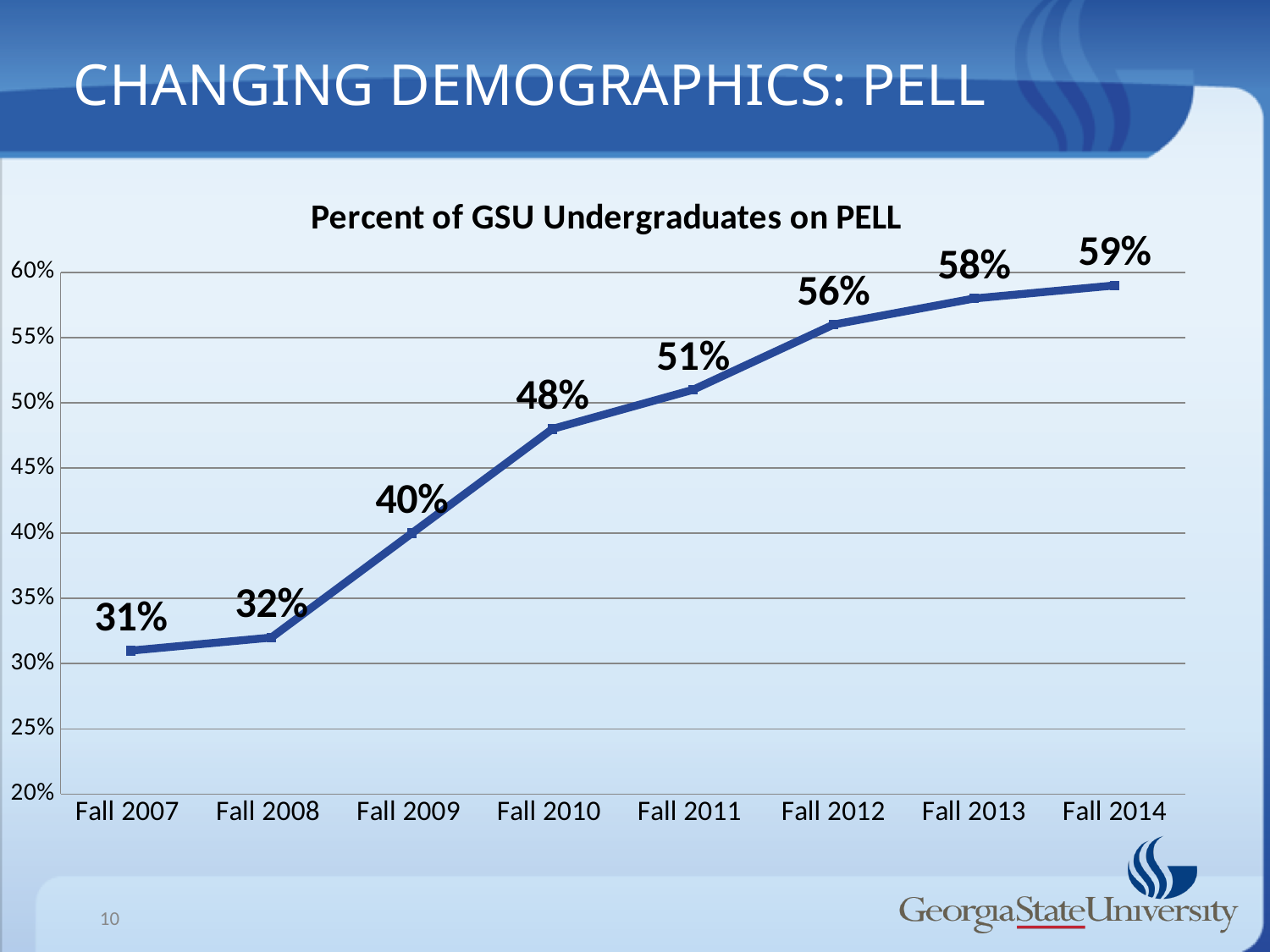
Which term has the lowest percent of undergraduates on PELL? Fall 2007 Do the values rise or fall from Fall 2007 to Fall 2014? Rise Which is larger, the value for Fall 2011 or the value for Fall 2009? Fall 2011 What percent of GSU undergraduates were on PELL in Fall 2010? 48% What is the difference in percentage points between Fall 2014 and Fall 2007? 28 What kind of chart is shown on the slide? Line chart What is the value shown for Fall 2007? 31% What is the title of the chart? Percent of GSU Undergraduates on PELL How many data points are plotted on the chart? 8 What is the value shown for Fall 2012? 56% Which term has the highest percent of undergraduates on PELL? Fall 2014 By how many percentage points did the value increase from Fall 2009 to Fall 2010? 8